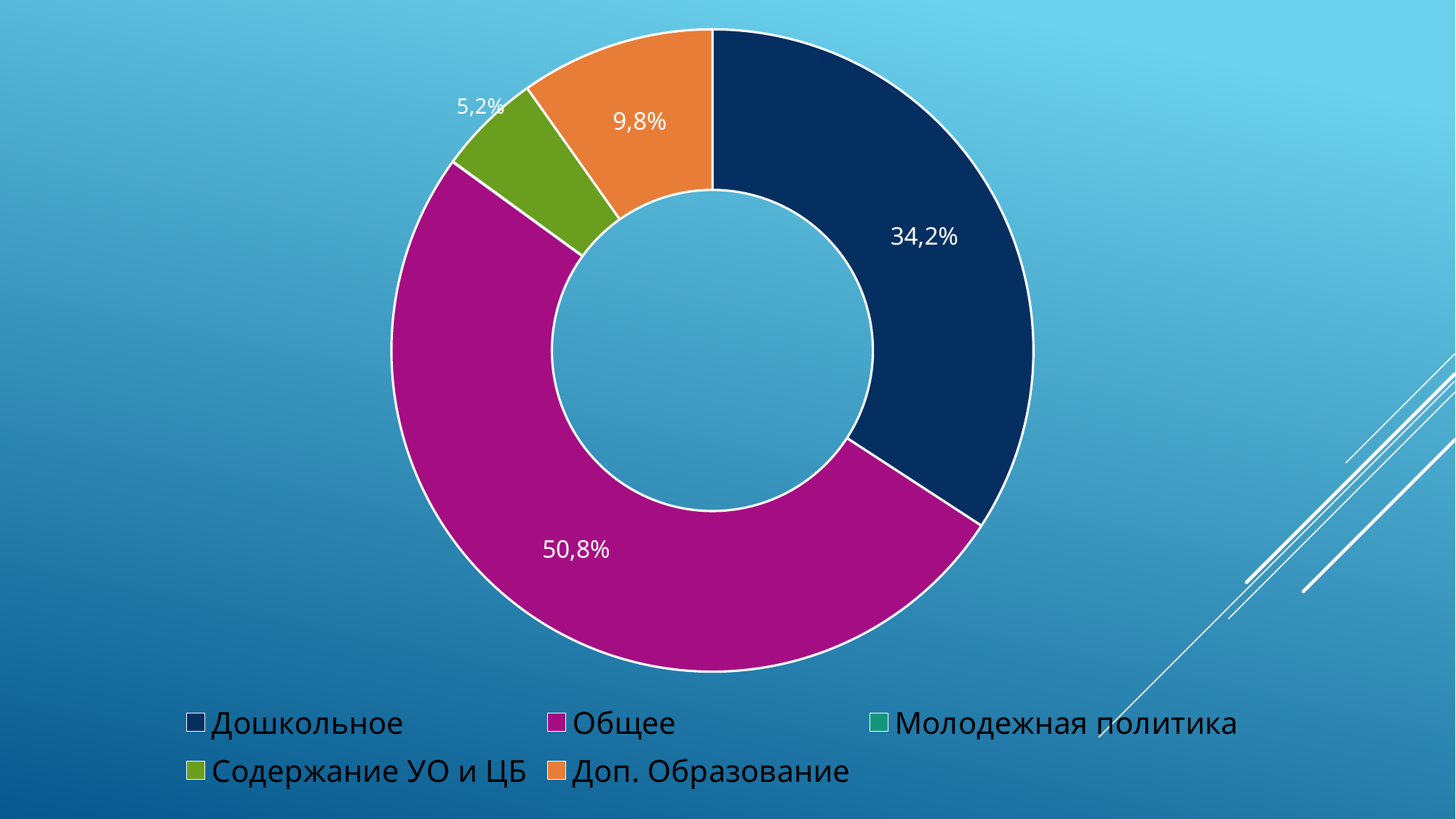
What kind of chart is shown on the slide? Pie (doughnut) chart How much larger is the share of Доп. Образование than that of Содержание УО и ЦБ? 4,6% What is the value shown for Дошкольное? 34,2% What is the difference between the shares of Общее and Дошкольное? 16,6% Which is larger, the share of Дошкольное or the share of Доп. Образование? Дошкольное What percentage is labelled for Доп. Образование? 9,8% How many categories does the legend list? 5 Which category has the largest slice? Общее Which category has the smallest labelled slice? Содержание УО и ЦБ What colour is the slice for Общее? Magenta (purple) What is the value for Содержание УО и ЦБ? 5,2% What share of the pie does Общее account for? 50,8%